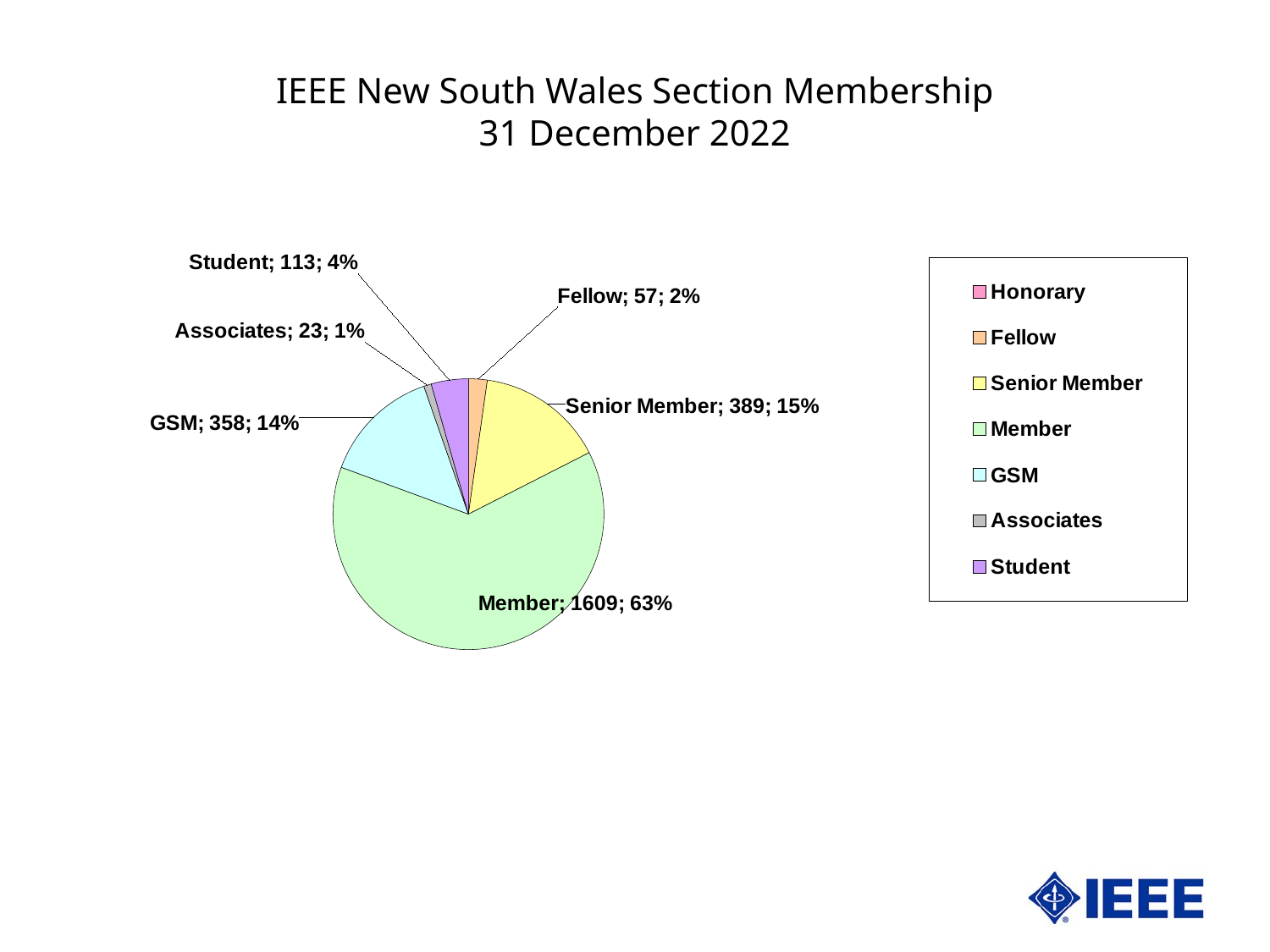
What is the difference between the Senior Member count and the GSM count? 31 What colour is the Member slice? light green Which is larger, the Student count or the Fellow count? Student How many entries does the legend list? 7 Which category has the largest slice of the pie? Member Which labelled category has the smallest slice of the pie? Associates What percentage share does the Student slice have? 4% How many members are in the GSM category? 358 How many members are in the Member category? 1609 What kind of chart is shown on the slide? pie chart What percentage share does the Senior Member slice have? 15% What is the title of the chart? IEEE New South Wales Section Membership 31 December 2022